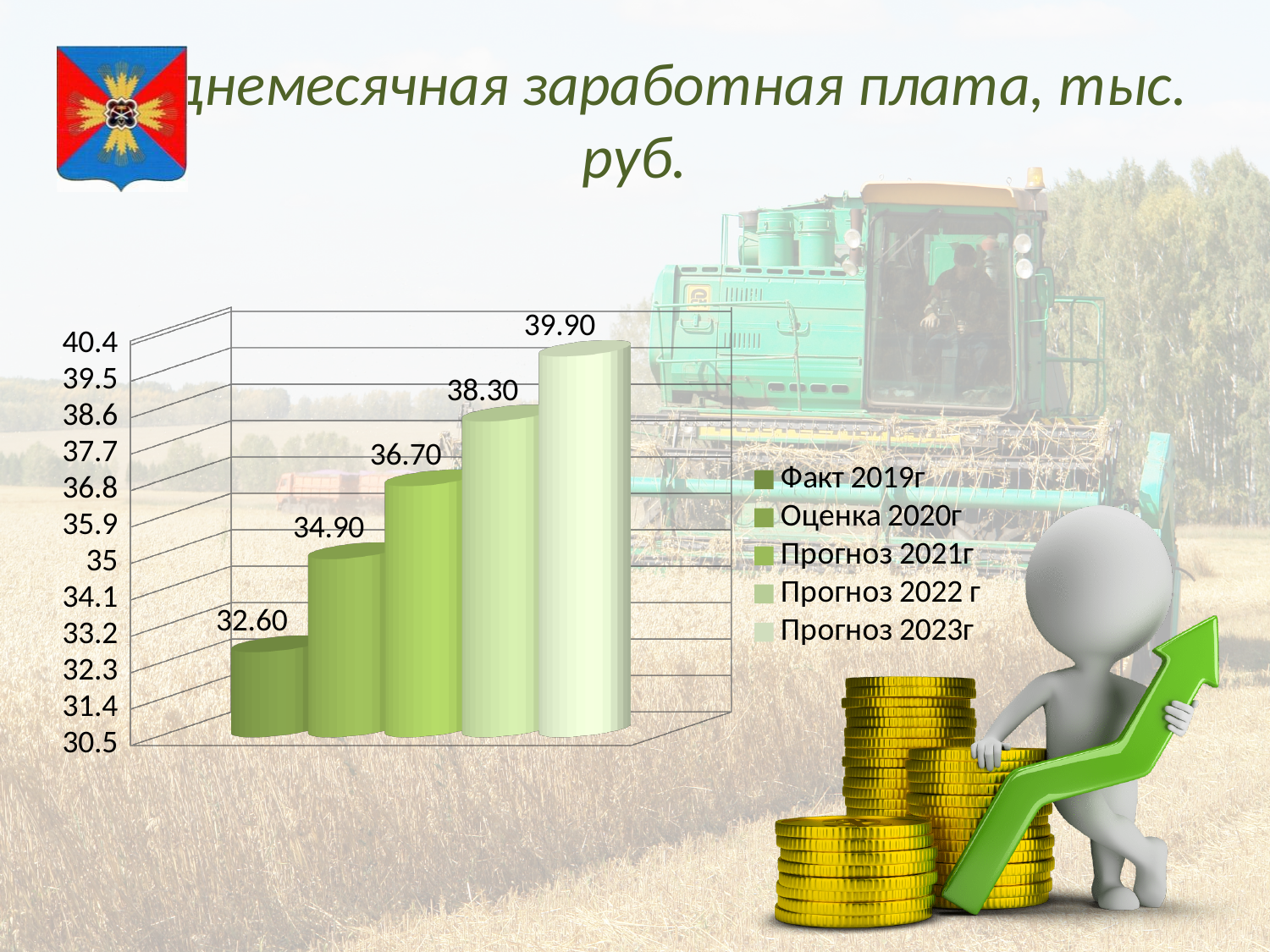
What is the value for Прогноз 2022 г? 38.30 Which is larger, the value for Оценка 2020г or the value for Прогноз 2021г? Прогноз 2021г What is the value for Прогноз 2023г? 39.90 How many entries does the legend list? 5 What is the value for Прогноз 2021г? 36.70 Which legend entry has the highest value? Прогноз 2023г How many bars are plotted on the chart? 5 What is the value for Оценка 2020г? 34.90 Which legend entry has the lowest value? Факт 2019г What is the value for Факт 2019г? 32.60 What is the difference between the values for Прогноз 2023г and Факт 2019г? 7.30 Do the values rise or fall from Факт 2019г to Прогноз 2023г? rise